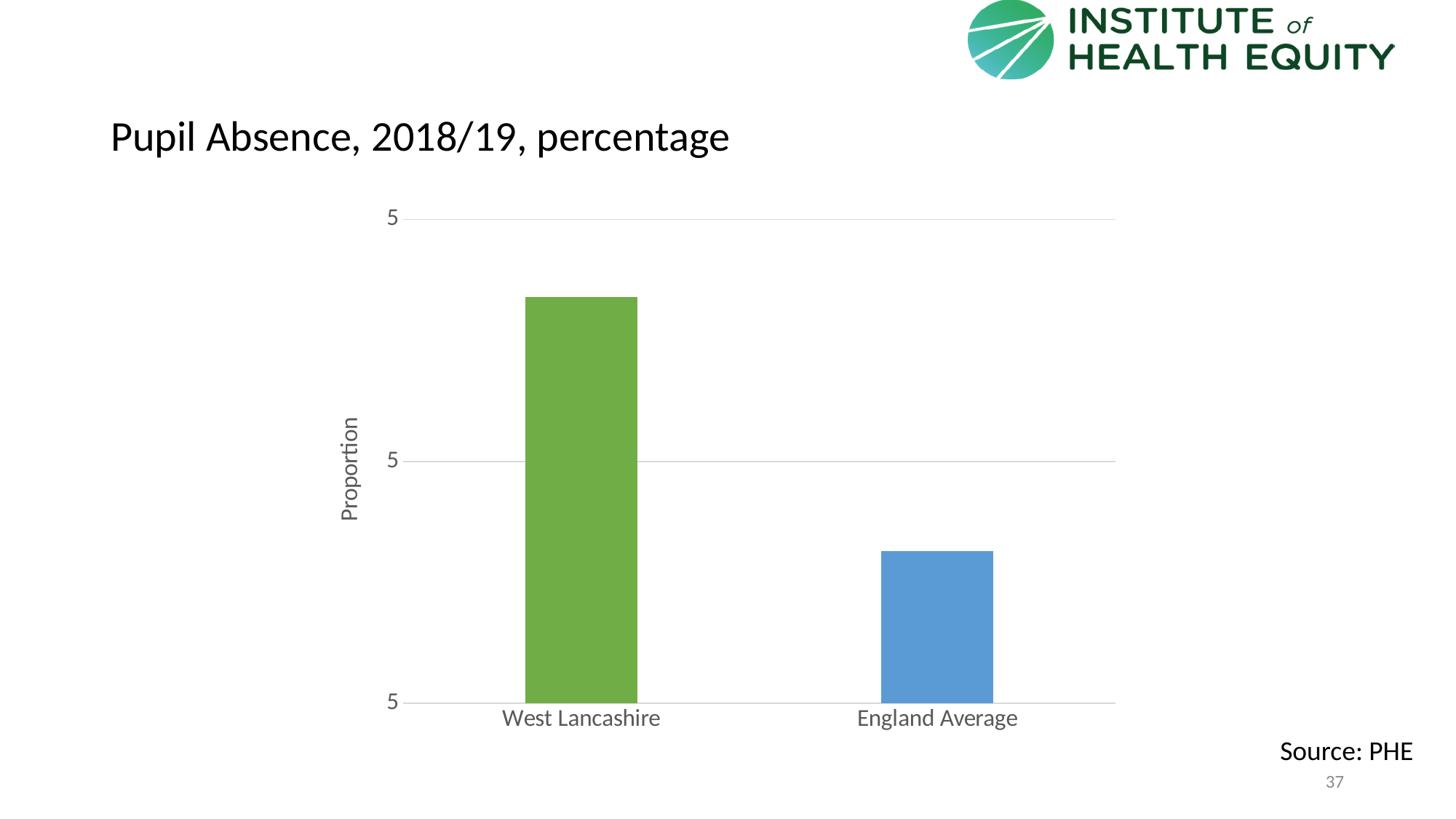
What is the title of the chart? Pupil Absence, 2018/19, percentage What is the label on the vertical axis? Proportion Which category has the highest pupil absence? West Lancashire What kind of chart is shown on the slide? bar chart Which is larger, the value for West Lancashire or the value for England Average? West Lancashire Which category has the lowest pupil absence? England Average How many categories are plotted on the chart? 2